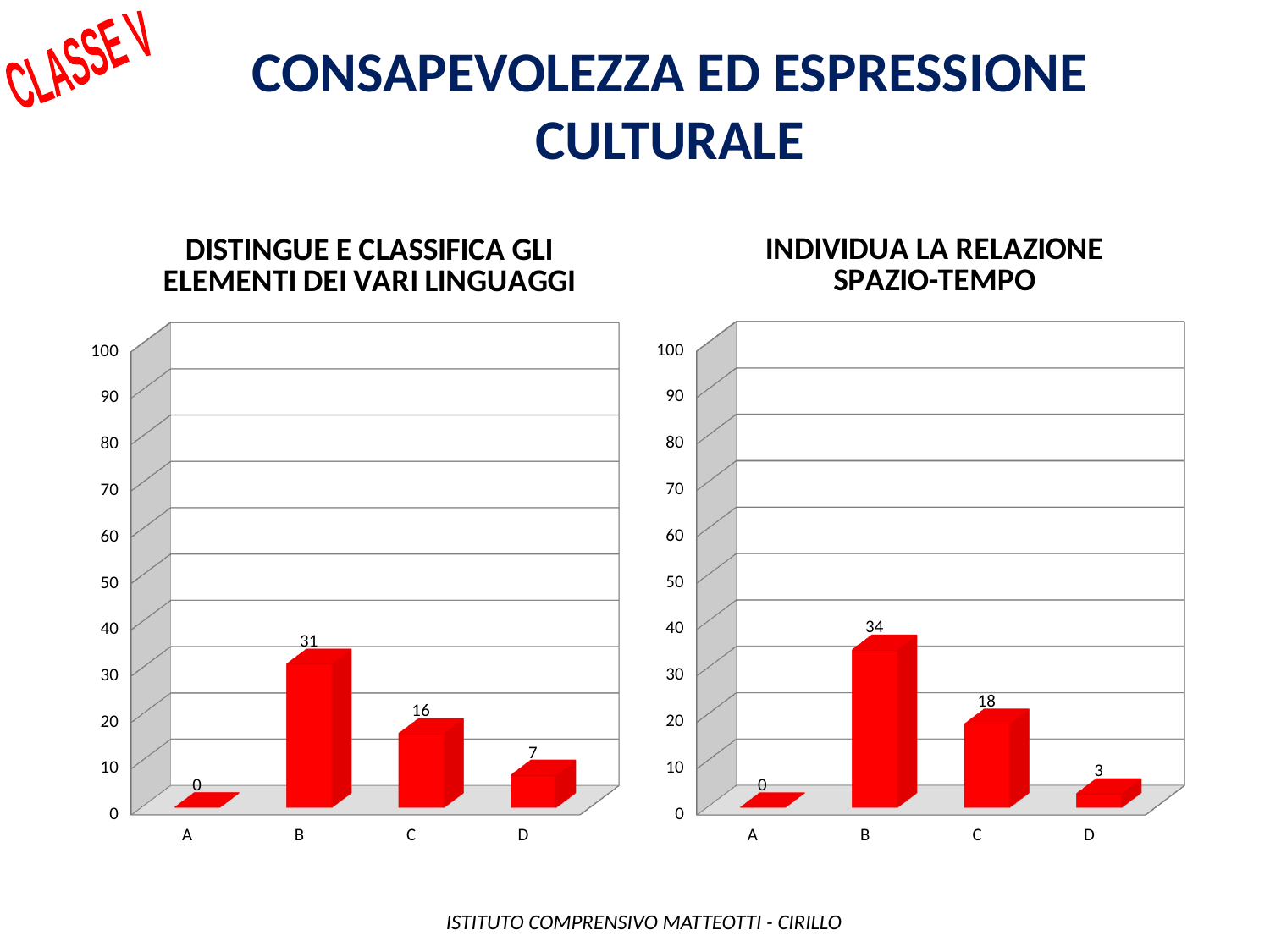
In the chart titled 'INDIVIDUA LA RELAZIONE SPAZIO-TEMPO', what is the value for category C? 18 In the left chart, which category has the highest value? B In the chart titled 'INDIVIDUA LA RELAZIONE SPAZIO-TEMPO', what is the value for category D? 3 In the left chart, what is the difference between the values for B and C? 15 In the right chart, which category has the lowest value? A In the chart titled 'DISTINGUE E CLASSIFICA GLI ELEMENTI DEI VARI LINGUAGGI', what is the value for category B? 31 How many categories are shown in the right chart? 4 Which is larger: the value for B in the left chart or the value for B in the right chart? B in the right chart What kind of chart is the left chart? bar chart What is the title of the right chart? INDIVIDUA LA RELAZIONE SPAZIO-TEMPO In the right chart, what is the difference between the values for B and D? 31 In the left chart, is the value for C greater or less than 20? less